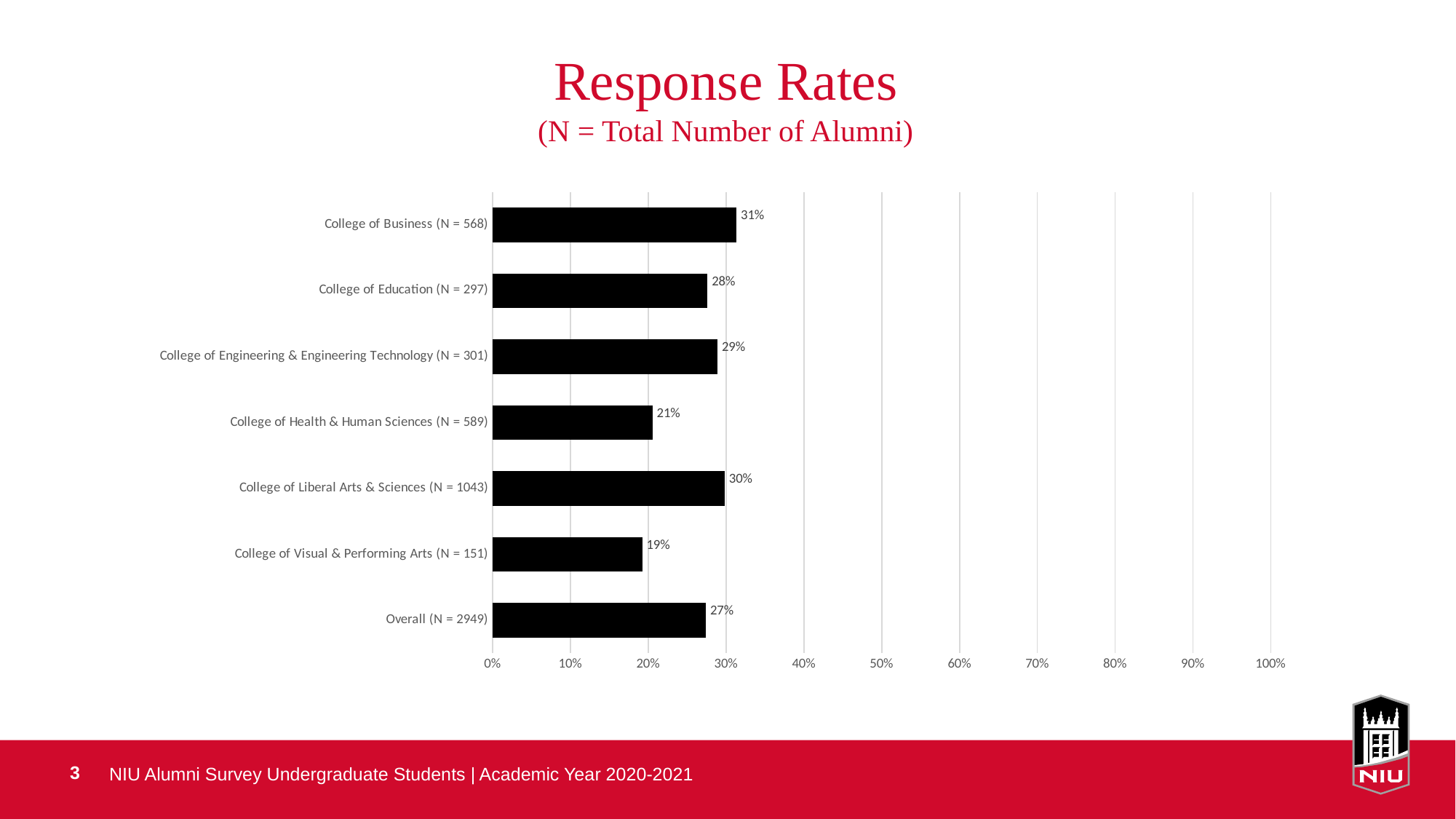
What is the difference between the response rates of the College of Business and the College of Visual & Performing Arts? 12% What is the Overall (N = 2949) response rate? 27% What is the response rate for the College of Business (N = 568)? 31% What is the title of the slide? Response Rates (N = Total Number of Alumni) Which category has the highest response rate? College of Business (N = 568) What kind of chart is shown on the slide? Bar chart What is the response rate for the College of Health & Human Sciences (N = 589)? 21% Which category has the lowest response rate? College of Visual & Performing Arts (N = 151) How many categories are shown in the chart? 7 Which has a higher response rate, the College of Education or the College of Health & Human Sciences? College of Education What is the difference between the response rates of the College of Liberal Arts & Sciences and the College of Health & Human Sciences? 9% What is the response rate for the College of Visual & Performing Arts (N = 151)? 19%